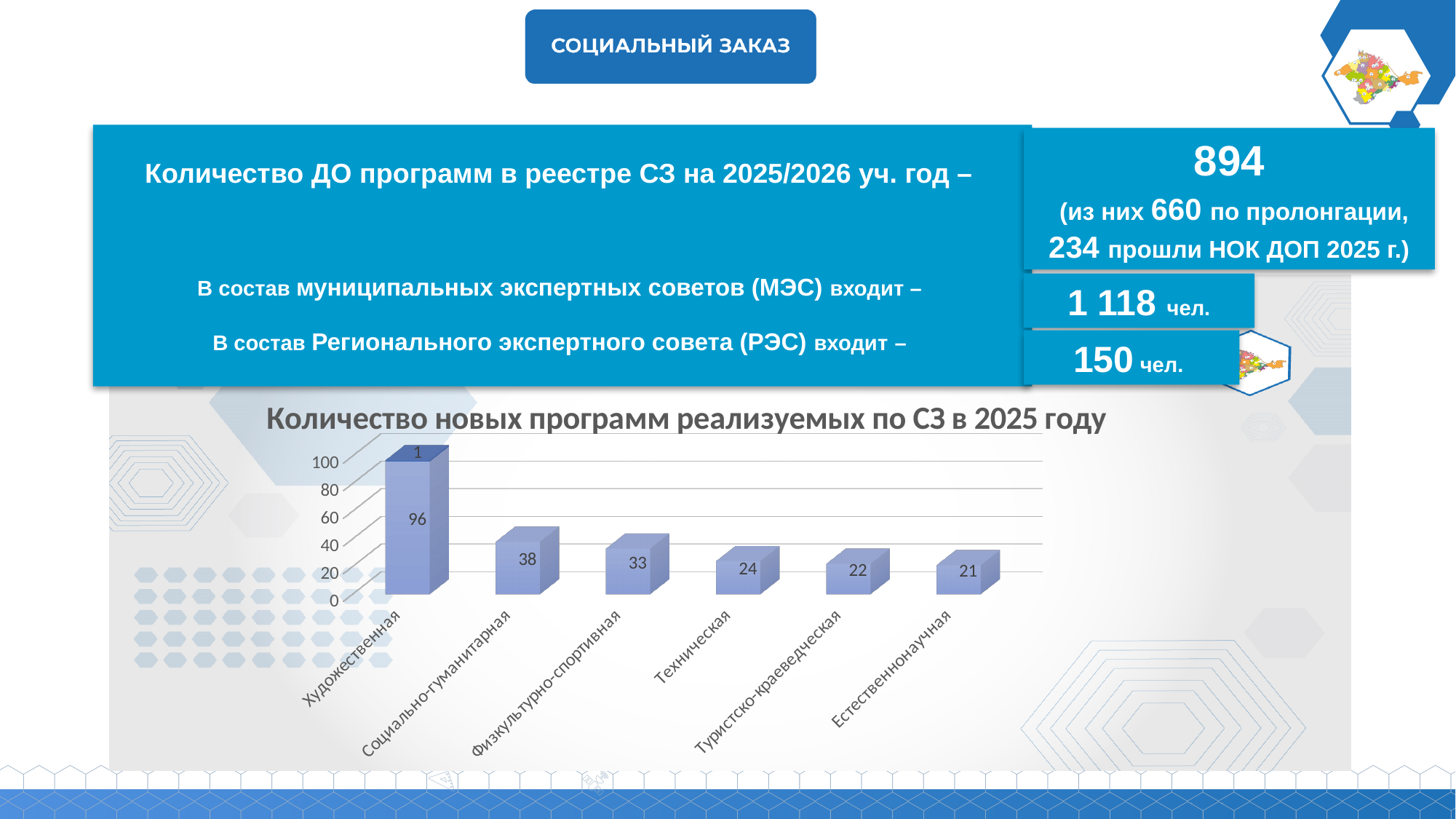
What is the title of the chart? Количество новых программ реализуемых по СЗ в 2025 году What kind of chart is shown on the slide? Bar chart What is the difference between the values for Художественная and Социально-гуманитарная? 58 Which category has the highest value in the chart? Художественная How many categories are shown on the x axis of the chart? 6 What is the value for Техническая? 24 What is the value for Художественная in the chart? 96 Which category has the lowest value in the chart? Естественнонаучная Which is larger, the value for Техническая or the value for Туристско-краеведческая? Техническая What is the value for Физкультурно-спортивная? 33 What is the value for Социально-гуманитарная? 38 What is the value for Естественнонаучная? 21